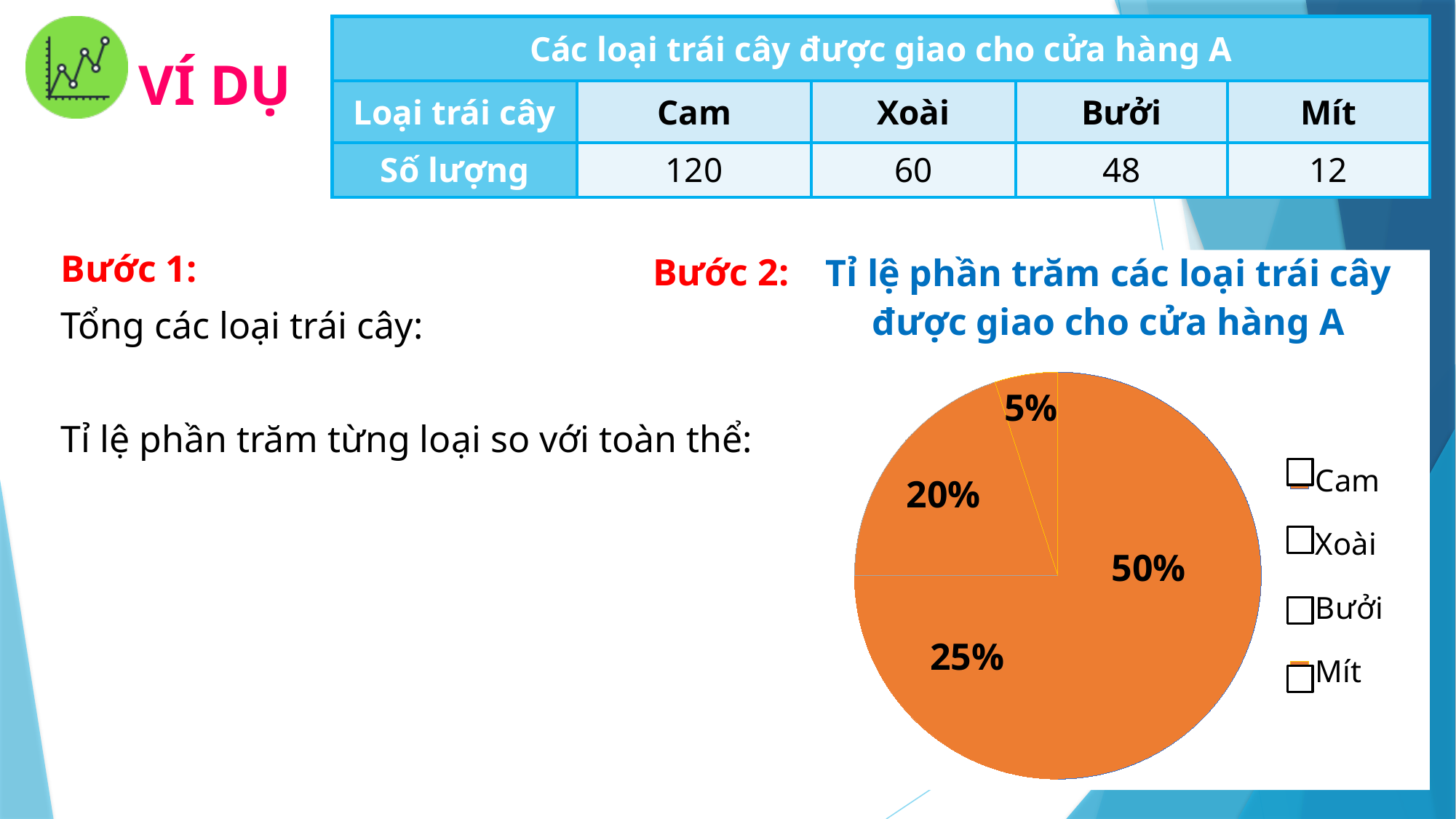
How many slices does the pie chart have? 4 In the pie chart, what share is shown for Mít? 5% What is the difference in percentage points between the 50% slice and the 20% slice in the pie chart? 30 Which category has the largest slice in the pie chart? Cam How many entries does the pie chart's legend list? 4 What is the smallest percentage shown on the pie chart? 5% What is the largest percentage shown on the pie chart? 50% In the pie chart, what share is shown for Cam? 50% In the pie chart, what share is shown for Xoài? 25% What is the title of the pie chart? Tỉ lệ phần trăm các loại trái cây được giao cho cửa hàng A What kind of chart is shown on the slide? pie chart